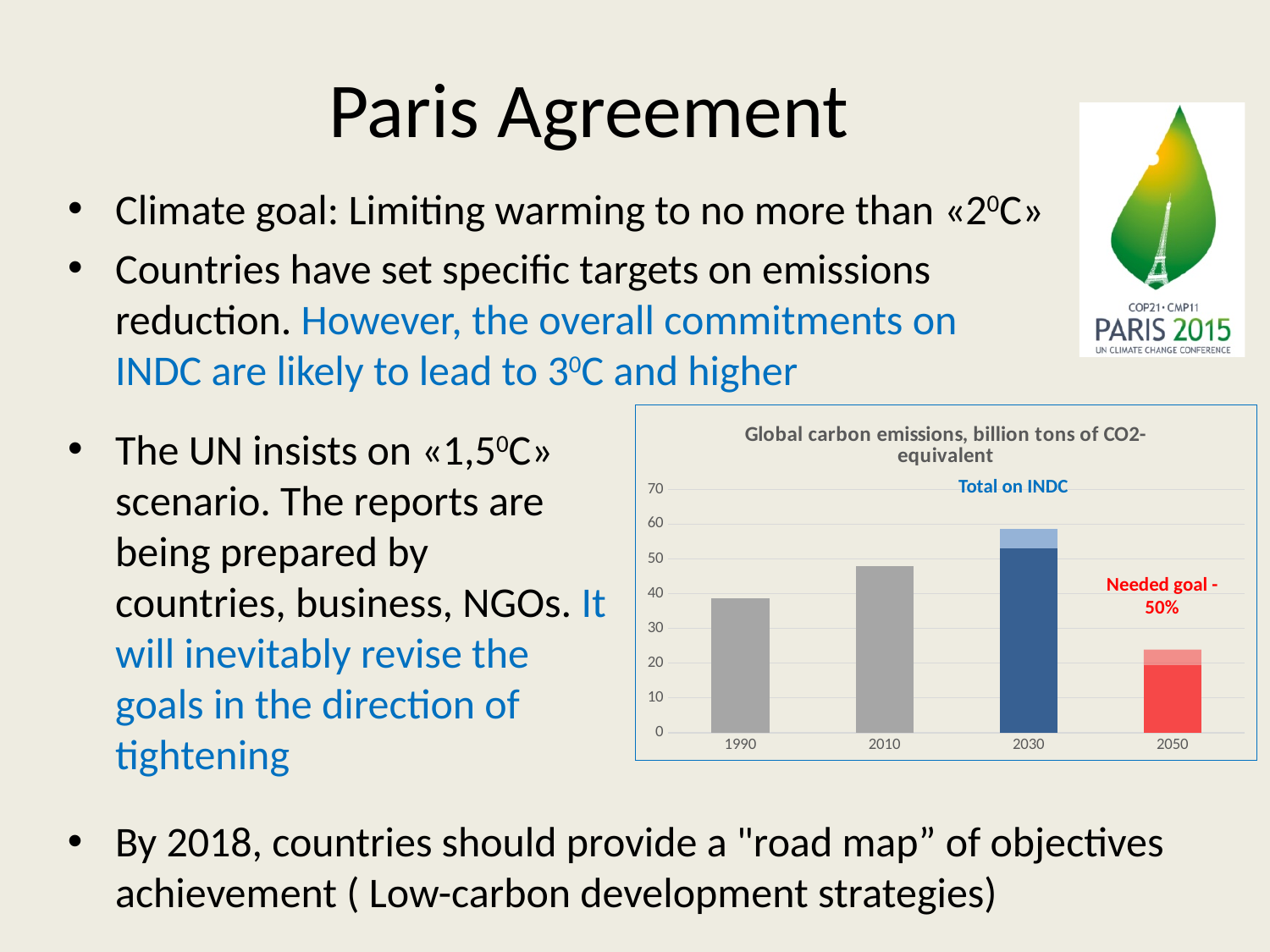
What label is written above the 2030 bar? Total on INDC How many years are shown on the x axis of the chart? 4 Is the total bar height for 2050 greater or less than 30? less Is the value for 2010 greater or less than 40? greater What is the title of the chart? Global carbon emissions, billion tons of CO2-equivalent Which year has the tallest bar in the chart? 2030 Is the total bar height for 2030 greater or less than 50? greater Which is larger, the value for 1990 or the value for 2010? 2010 Do the bars rise or fall from 1990 to 2030? rise Which year has the shortest bar in the chart? 2050 What type of chart is shown on the slide? bar chart